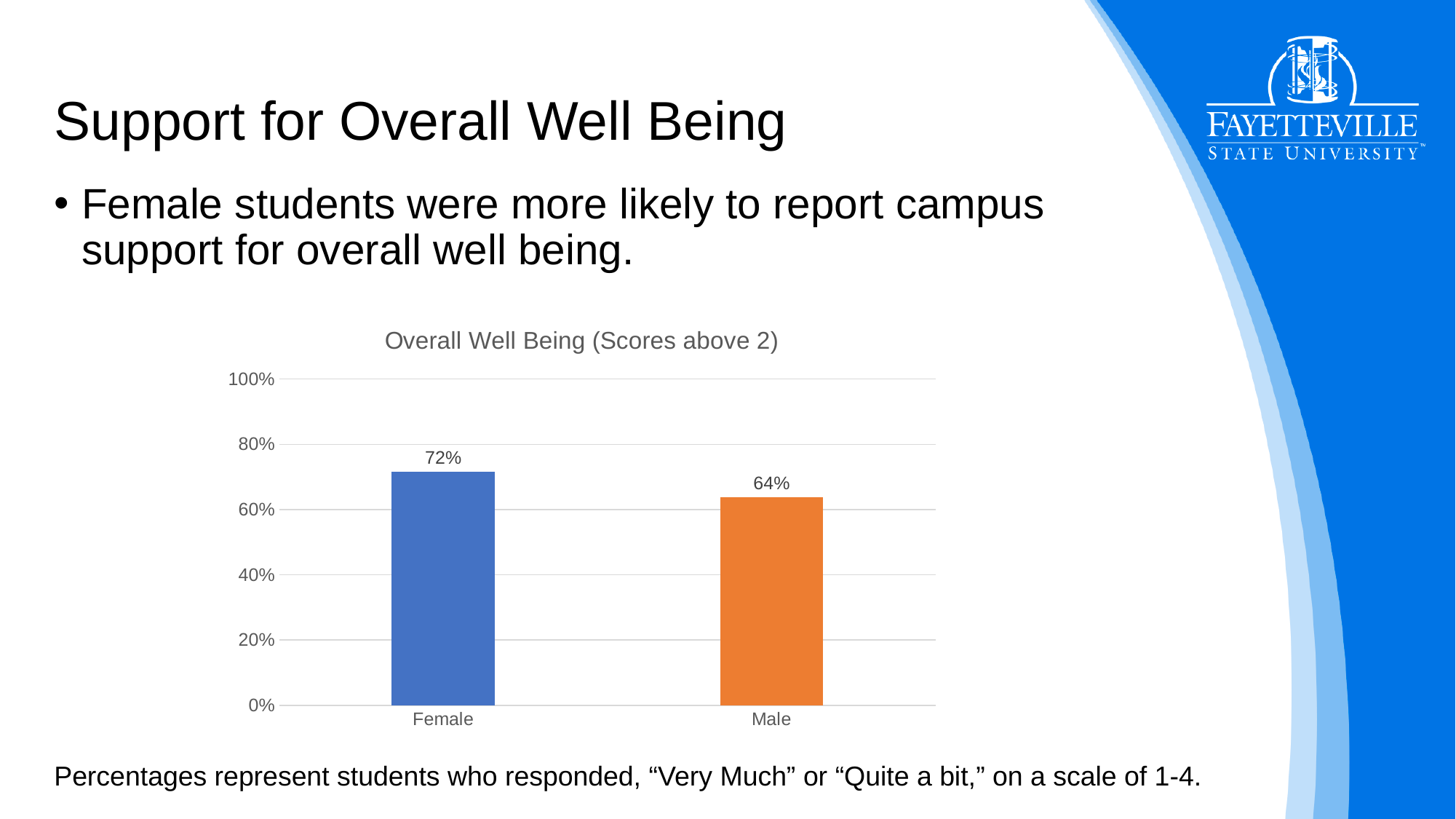
Which is larger, the value for Female or the value for Male? Female Is the value for Male greater or less than 80%? less Which category has the highest value? Female What kind of chart is shown on the slide? bar chart Is the value for Female greater or less than 60%? greater What is the title of the chart? Overall Well Being (Scores above 2) What is the difference between the Female and Male values? 8% What is the value for Male in the chart? 64% What is the value for Female in the chart? 72% Which category has the lowest value? Male How many categories are shown in the chart? 2 What colour is the bar for Male? orange